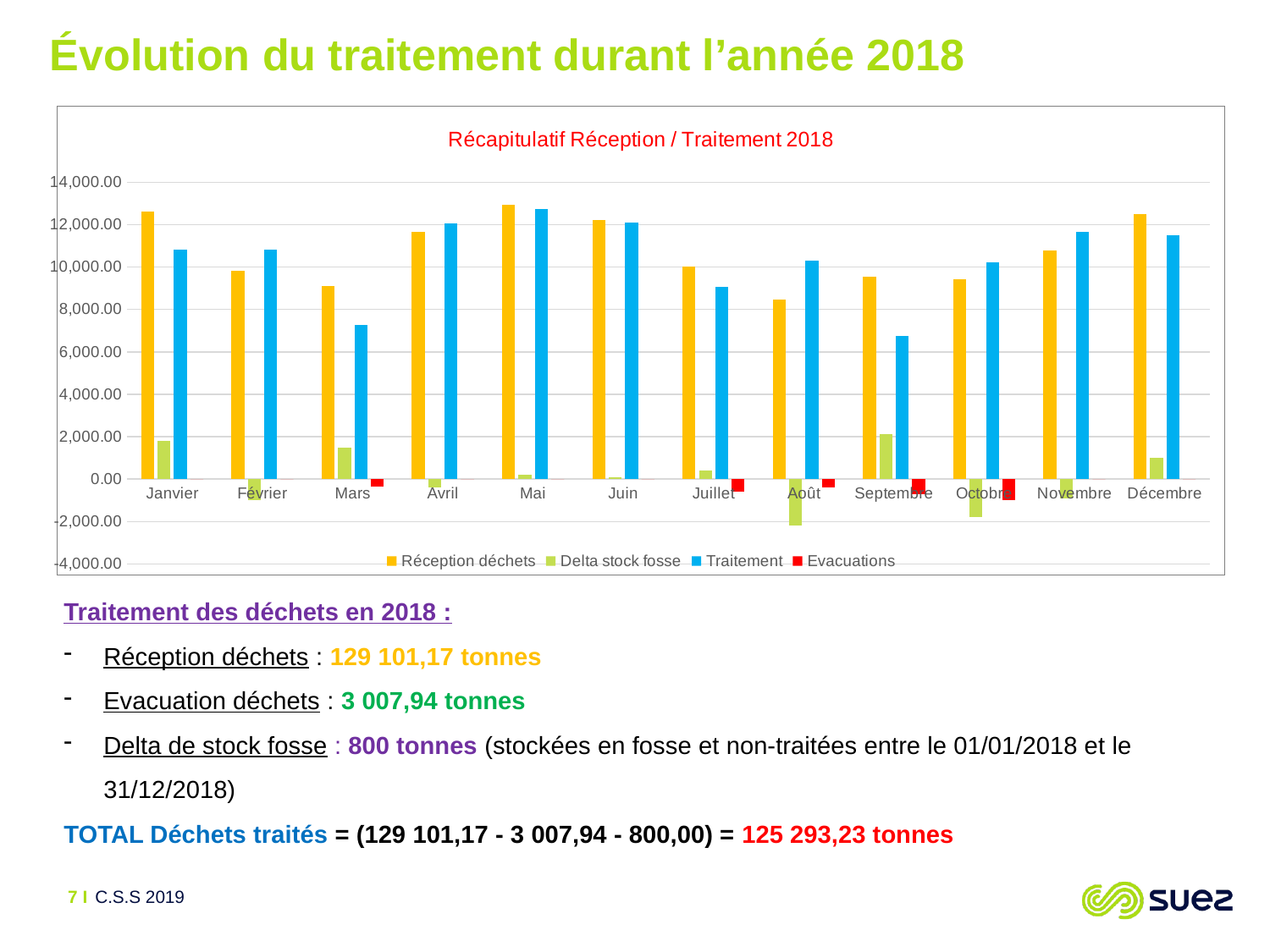
In Janvier, which is larger: Réception déchets or Traitement? Réception déchets What is the title of the chart? Récapitulatif Réception / Traitement 2018 Which month has the lowest value for Réception déchets? Août Is the Traitement value for Mars greater or less than 8,000.00? less Is the Réception déchets value for Janvier greater or less than 12,000.00? greater Which month has the lowest value for Traitement? Septembre How many series does the chart legend list? 4 Which month has the highest value for Traitement? Mai How many months are shown on the x axis of the chart? 12 In Août, which is larger: Réception déchets or Traitement? Traitement Is the Traitement value for Septembre greater or less than 8,000.00? less What kind of chart is shown on the slide? bar chart